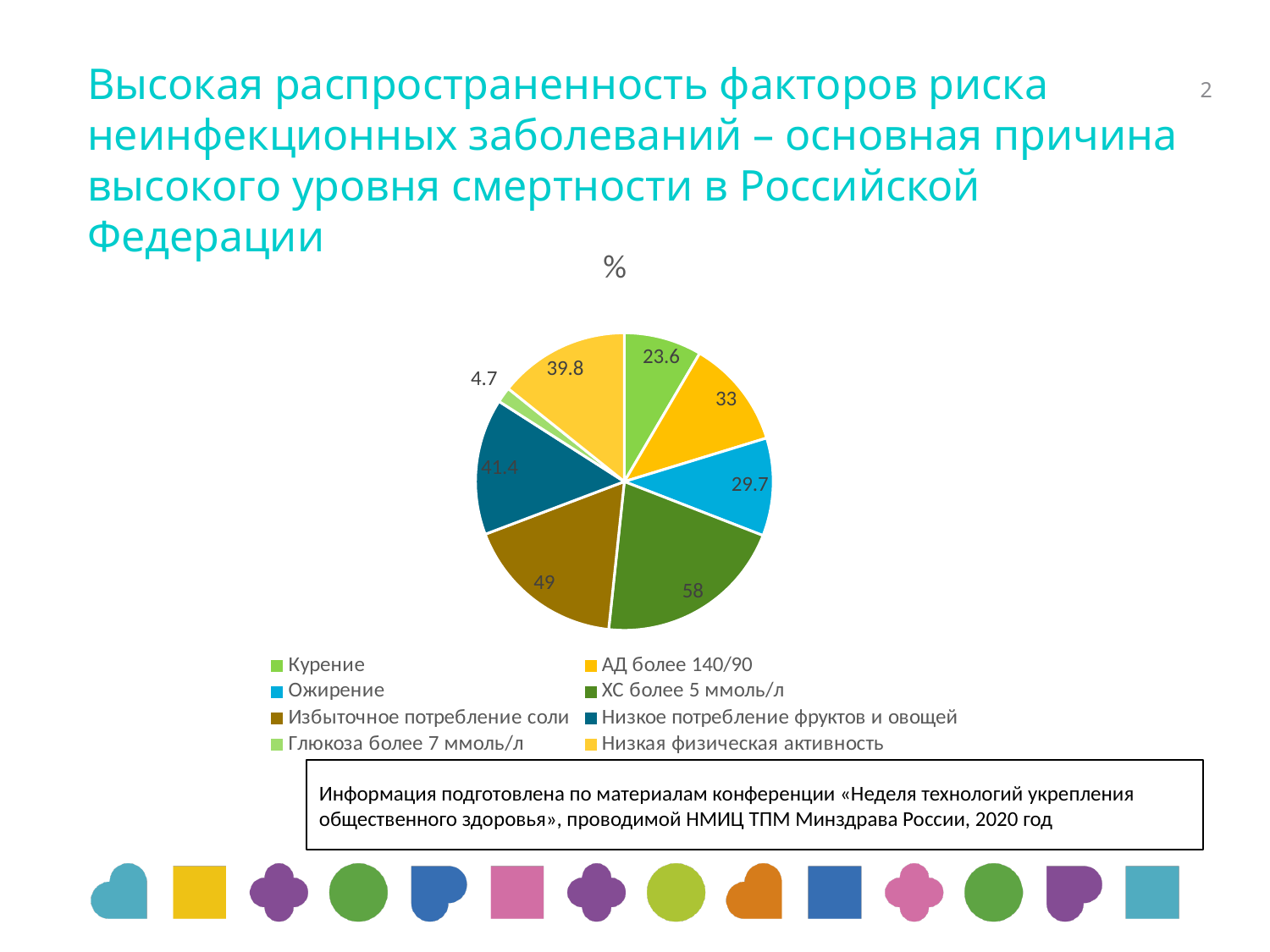
Which is larger, the value for АД более 140/90 or the value for Низкая физическая активность? Низкая физическая активность Which category has the largest value? ХС более 5 ммоль/л What is the value for Низкое потребление фруктов и овощей? 41.4 What is the value for Глюкоза более 7 ммоль/л? 4.7 What is the value for ХС более 5 ммоль/л? 58 What is the difference between the values for Избыточное потребление соли and Ожирение? 19.3 What kind of chart is shown on the slide? pie chart What is the title of the chart? % How many categories does the pie chart show? 8 Which category has the smallest value? Глюкоза более 7 ммоль/л What colour is the slice for Избыточное потребление соли? brown What is the value for Курение? 23.6